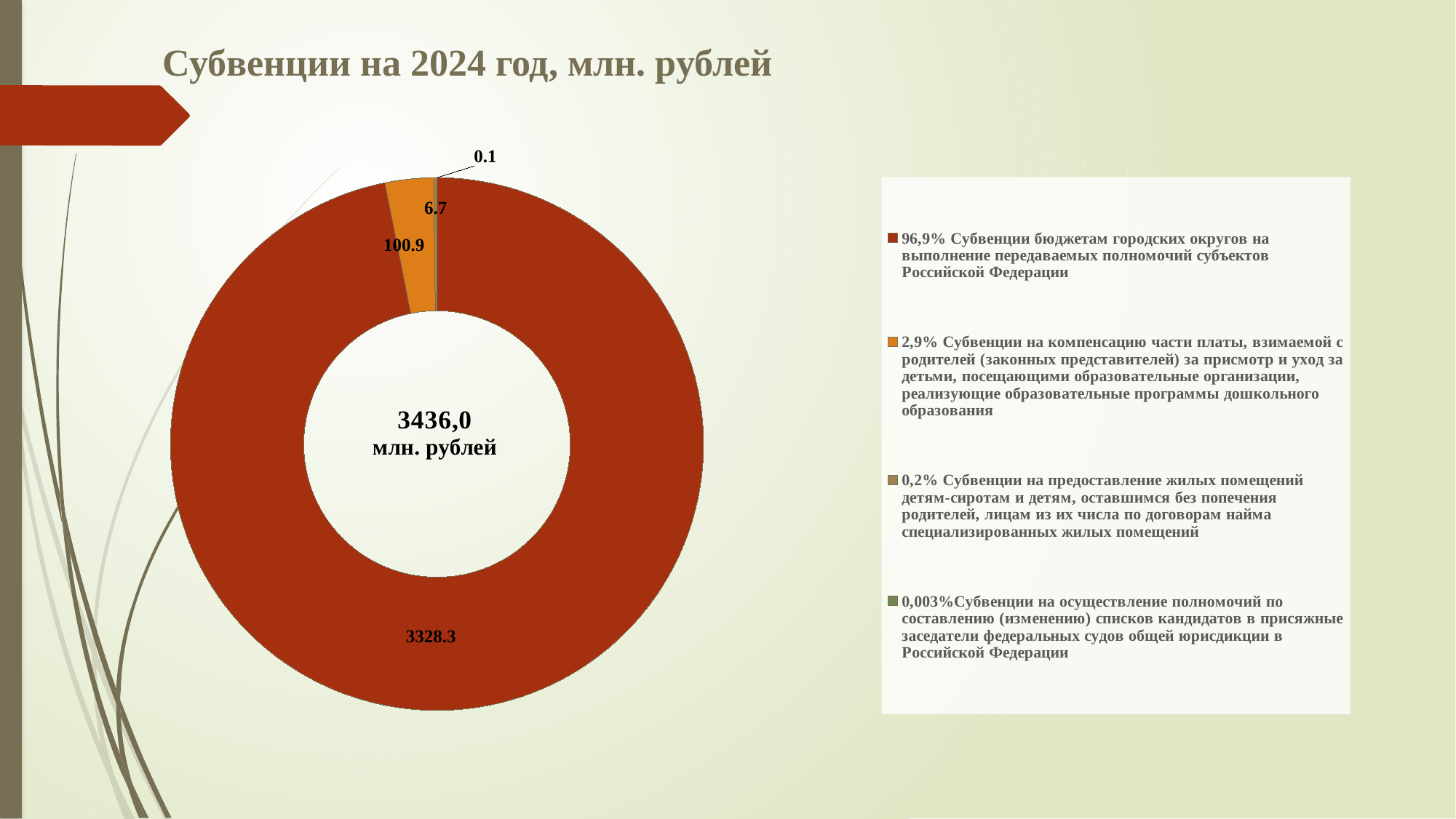
What is the difference between the value for 'Субвенции бюджетам городских округов' (3328.3) and the value for 'Субвенции на компенсацию части платы' (100.9)? 3227.4 How many categories does the chart show? 4 What is the value for the slice 'Субвенции на предоставление жилых помещений детям-сиротам и детям, оставшимся без попечения родителей'? 6.7 Which category has the largest slice? Субвенции бюджетам городских округов на выполнение передаваемых полномочий субъектов Российской Федерации Which is larger: the slice for 'Субвенции на компенсацию части платы' or the slice for 'Субвенции на предоставление жилых помещений детям-сиротам'? Субвенции на компенсацию части платы Which category has the smallest slice? Субвенции на осуществление полномочий по составлению (изменению) списков кандидатов в присяжные заседатели федеральных судов общей юрисдикции в Российской Федерации What is the value for the slice 'Субвенции на компенсацию части платы, взимаемой с родителей (законных представителей) за присмотр и уход за детьми'? 100.9 What total is printed in the centre of the chart? 3436,0 млн. рублей What share of the chart does the slice 'Субвенции бюджетам городских округов' represent, according to the legend? 96,9% What is the value for the slice 'Субвенции бюджетам городских округов на выполнение передаваемых полномочий субъектов Российской Федерации'? 3328.3 What is the value for the slice 'Субвенции на осуществление полномочий по составлению (изменению) списков кандидатов в присяжные заседатели'? 0.1 What share of the chart does the slice 'Субвенции на компенсацию части платы, взимаемой с родителей' represent, according to the legend? 2,9%